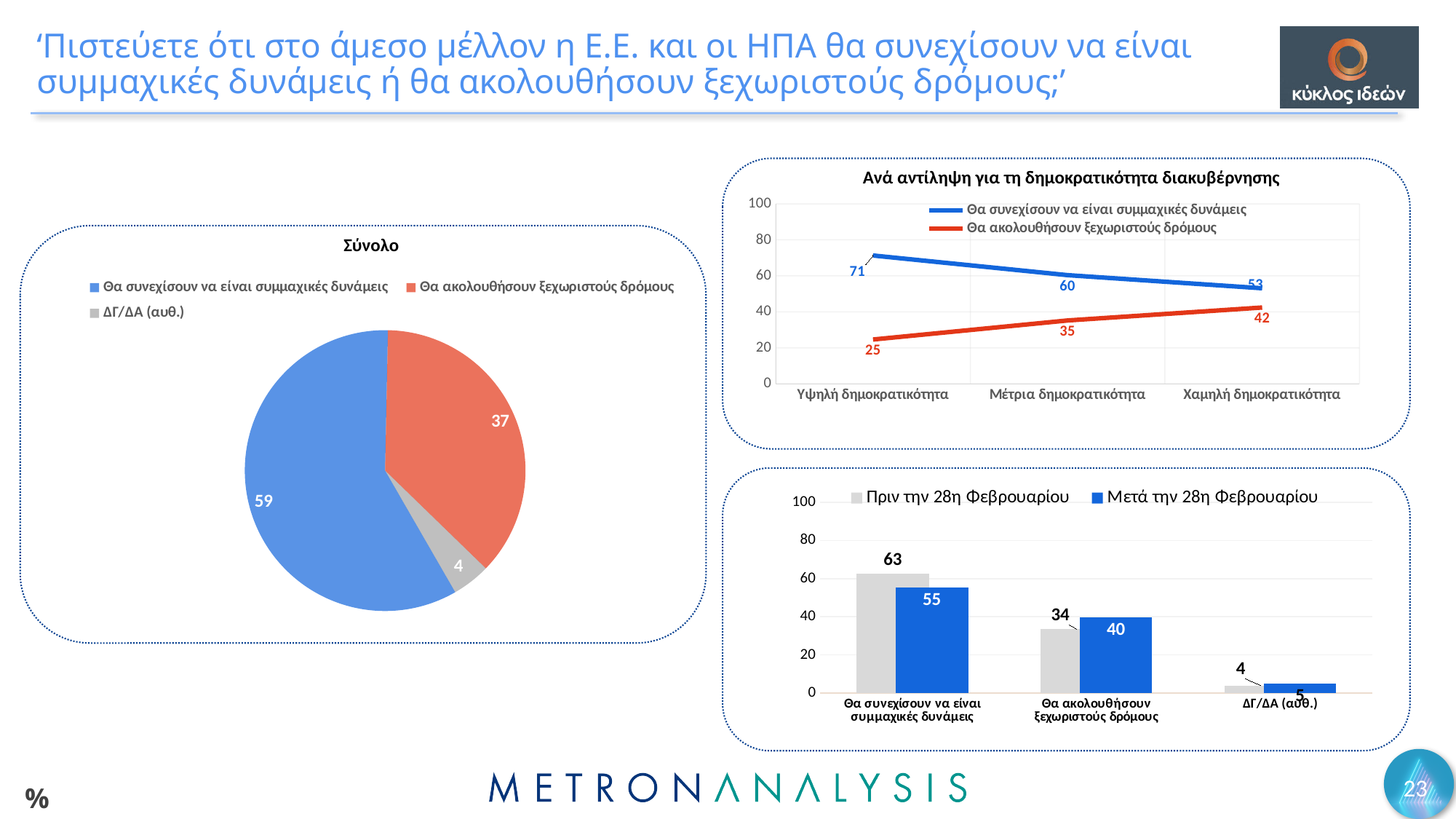
In the chart titled 'Ανά αντίληψη για τη δημοκρατικότητα διακυβέρνησης', what is the difference between the two series at 'Υψηλή δημοκρατικότητα'? 46 How many series does the legend of the bar chart at the bottom right list? 2 In the pie chart titled 'Σύνολο', what is the value for 'Θα συνεχίσουν να είναι συμμαχικές δυνάμεις'? 59 In the chart titled 'Ανά αντίληψη για τη δημοκρατικότητα διακυβέρνησης', does the 'Θα συνεχίσουν να είναι συμμαχικές δυνάμεις' line rise or fall from 'Υψηλή δημοκρατικότητα' to 'Χαμηλή δημοκρατικότητα'? fall In the chart titled 'Ανά αντίληψη για τη δημοκρατικότητα διακυβέρνησης', what is the value of 'Θα συνεχίσουν να είναι συμμαχικές δυνάμεις' for 'Μέτρια δημοκρατικότητα'? 60 What kind of chart is the one titled 'Ανά αντίληψη για τη δημοκρατικότητα διακυβέρνησης'? line chart In the pie chart titled 'Σύνολο', how many slices are there? 3 In the pie chart titled 'Σύνολο', what is the value for 'ΔΓ/ΔΑ (αυθ.)'? 4 In the bar chart at the bottom right, what is the value of 'Μετά την 28η Φεβρουαρίου' for 'Θα ακολουθήσουν ξεχωριστούς δρόμους'? 40 In the bar chart at the bottom right, what is the difference between 'Πριν την 28η Φεβρουαρίου' and 'Μετά την 28η Φεβρουαρίου' for 'Θα συνεχίσουν να είναι συμμαχικές δυνάμεις'? 8 In the chart titled 'Ανά αντίληψη για τη δημοκρατικότητα διακυβέρνησης', what is the value of 'Θα ακολουθήσουν ξεχωριστούς δρόμους' for 'Χαμηλή δημοκρατικότητα'? 42 In the pie chart titled 'Σύνολο', which slice is the largest? Θα συνεχίσουν να είναι συμμαχικές δυνάμεις